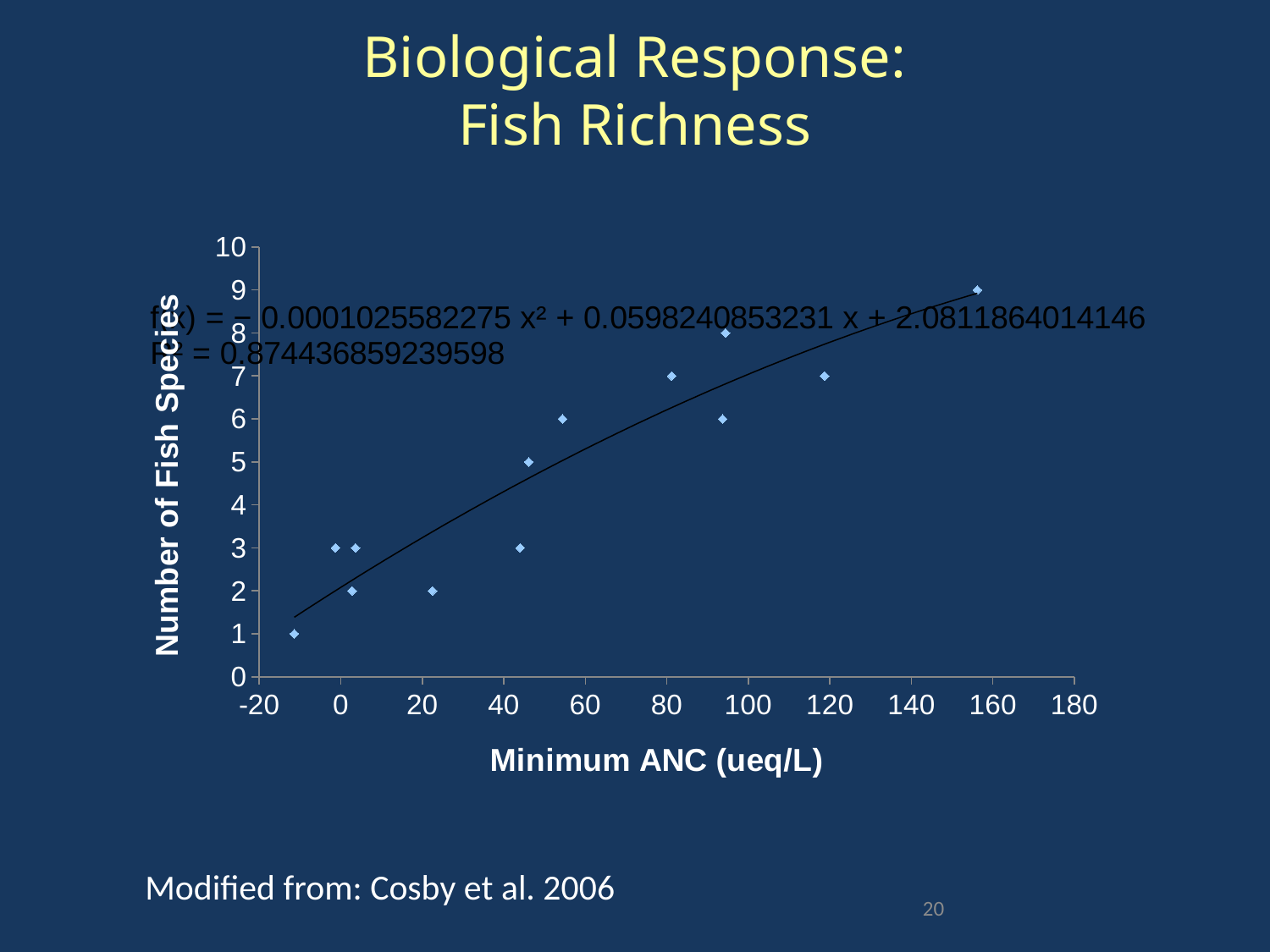
What is the maximum value shown on the y axis? 10 Is the Minimum ANC value of the point with 9 fish species greater or less than 140? greater What is the label of the y axis? Number of Fish Species What R² value is printed on the chart for the fitted trendline? 0.874436859239598 What is the difference between the highest and lowest number of fish species plotted? 8 How many data points are plotted on the chart? 13 What is the lowest number of fish species shown by any data point? 1 Does the number of fish species generally rise or fall as Minimum ANC increases? rise What is the highest number of fish species shown by any data point? 9 What is the label of the x axis? Minimum ANC (ueq/L) Is the Minimum ANC value of the point with 1 fish species greater or less than 0? less What kind of chart is shown on the slide? scatter plot